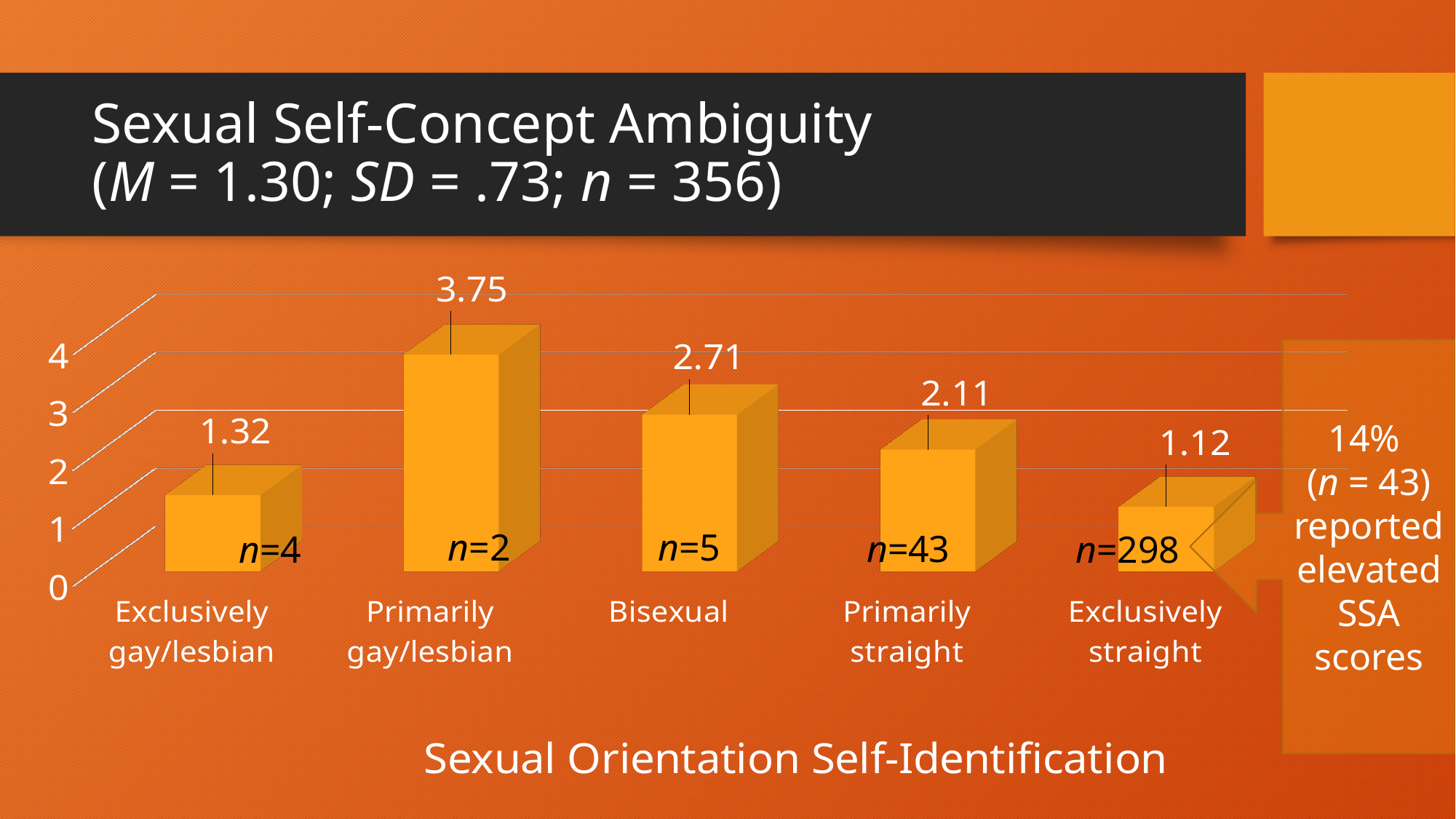
What is the x-axis title of the chart? Sexual Orientation Self-Identification What is the value for Bisexual? 2.71 What is the value for Primarily straight? 2.11 What is the sample size (n) shown for the Exclusively straight bar? n=298 Which category has the highest value? Primarily gay/lesbian What kind of chart is shown? Bar chart What is the difference between the values for Primarily gay/lesbian and Bisexual? 1.04 What is the value for Primarily gay/lesbian? 3.75 How many categories are shown on the x axis? 5 Which category has the lowest value? Exclusively straight Which is larger, the value for Exclusively gay/lesbian or the value for Primarily straight? Primarily straight What is the value for Exclusively straight? 1.12